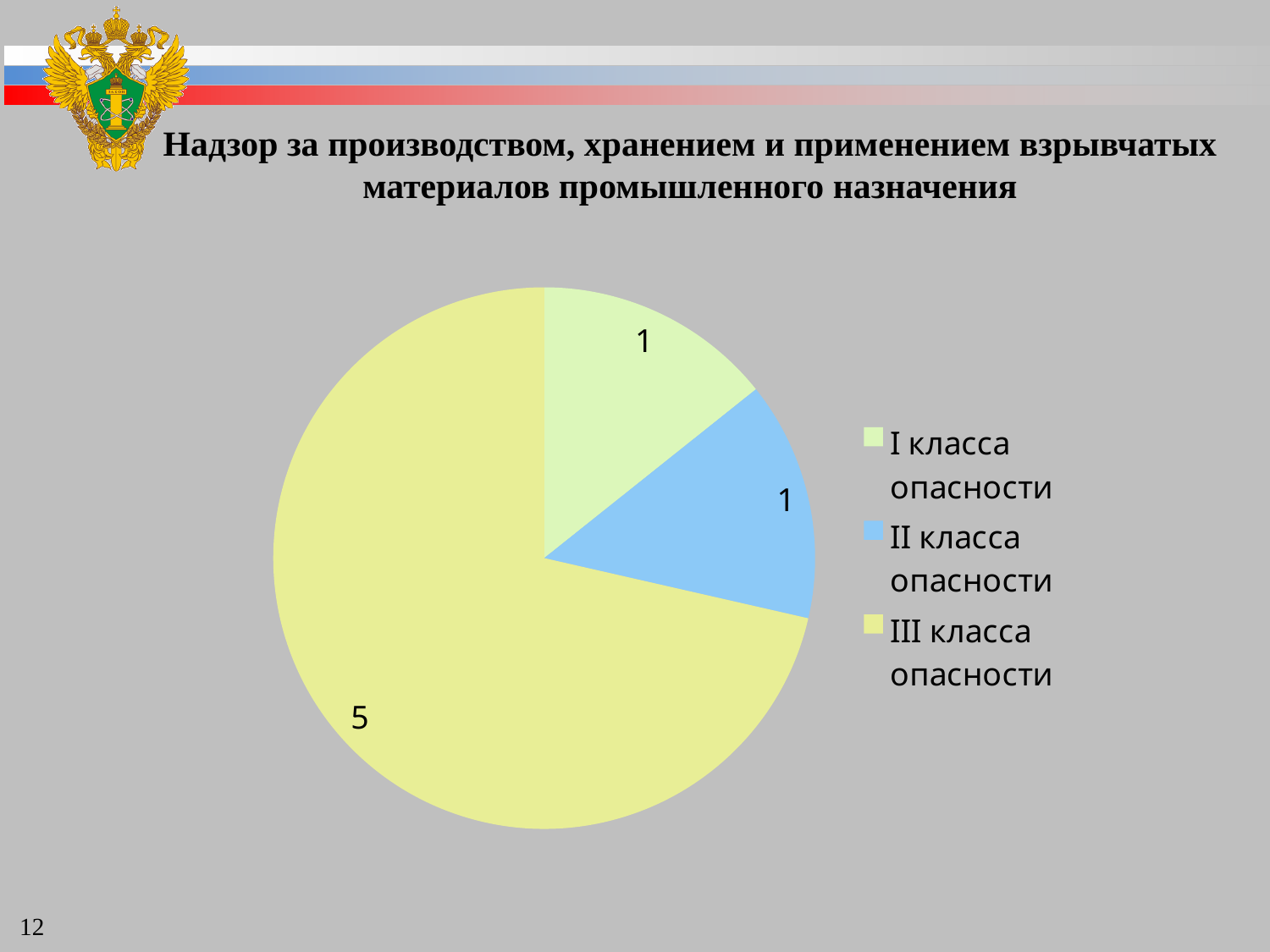
What is the total of all slices in the pie chart? 7 What is the value for II класса опасности? 1 What share of the pie does III класса опасности represent? 5/7 How many entries does the legend list? 3 What is the value for III класса опасности? 5 What colour is the slice for II класса опасности? blue Which category has the largest slice of the pie? III класса опасности What is the value for I класса опасности? 1 What kind of chart is shown on the slide? pie chart How many categories does the pie chart show? 3 Which is larger, the value for III класса опасности or the value for II класса опасности? III класса опасности What is the difference between the values for III класса опасности and I класса опасности? 4